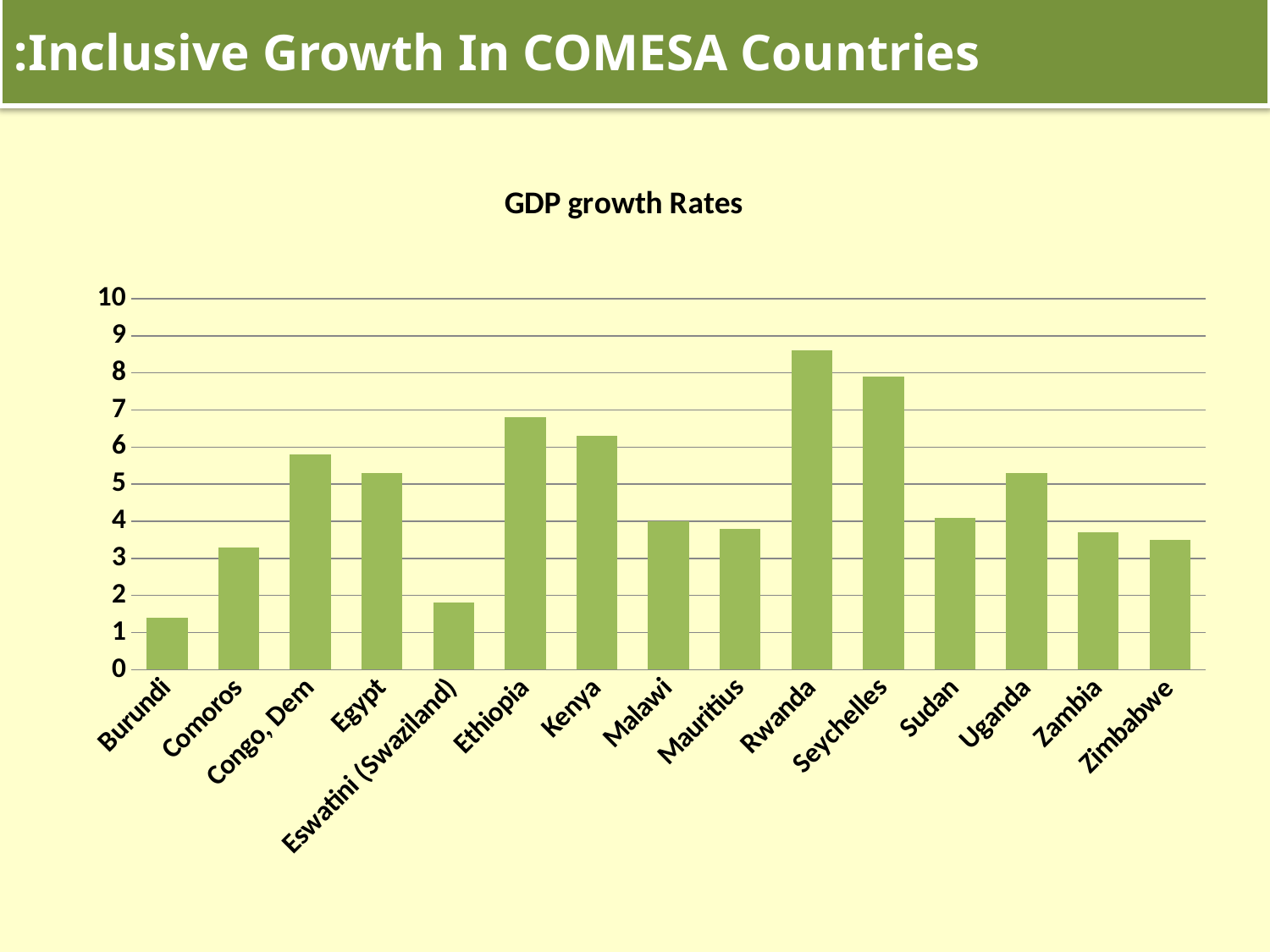
Is the value for Congo, Dem greater or less than 5? greater How many countries are shown on the x axis of the chart? 15 Which country has the lowest GDP growth rate in the chart? Burundi Is the value for Burundi greater or less than 2? less Which has the larger GDP growth rate, Rwanda or Seychelles? Rwanda Which country has the highest GDP growth rate in the chart? Rwanda What kind of chart is shown on the slide? bar chart Is the value for Seychelles greater or less than 7? greater What is the title of the chart? GDP growth Rates Which has the larger GDP growth rate, Ethiopia or Kenya? Ethiopia